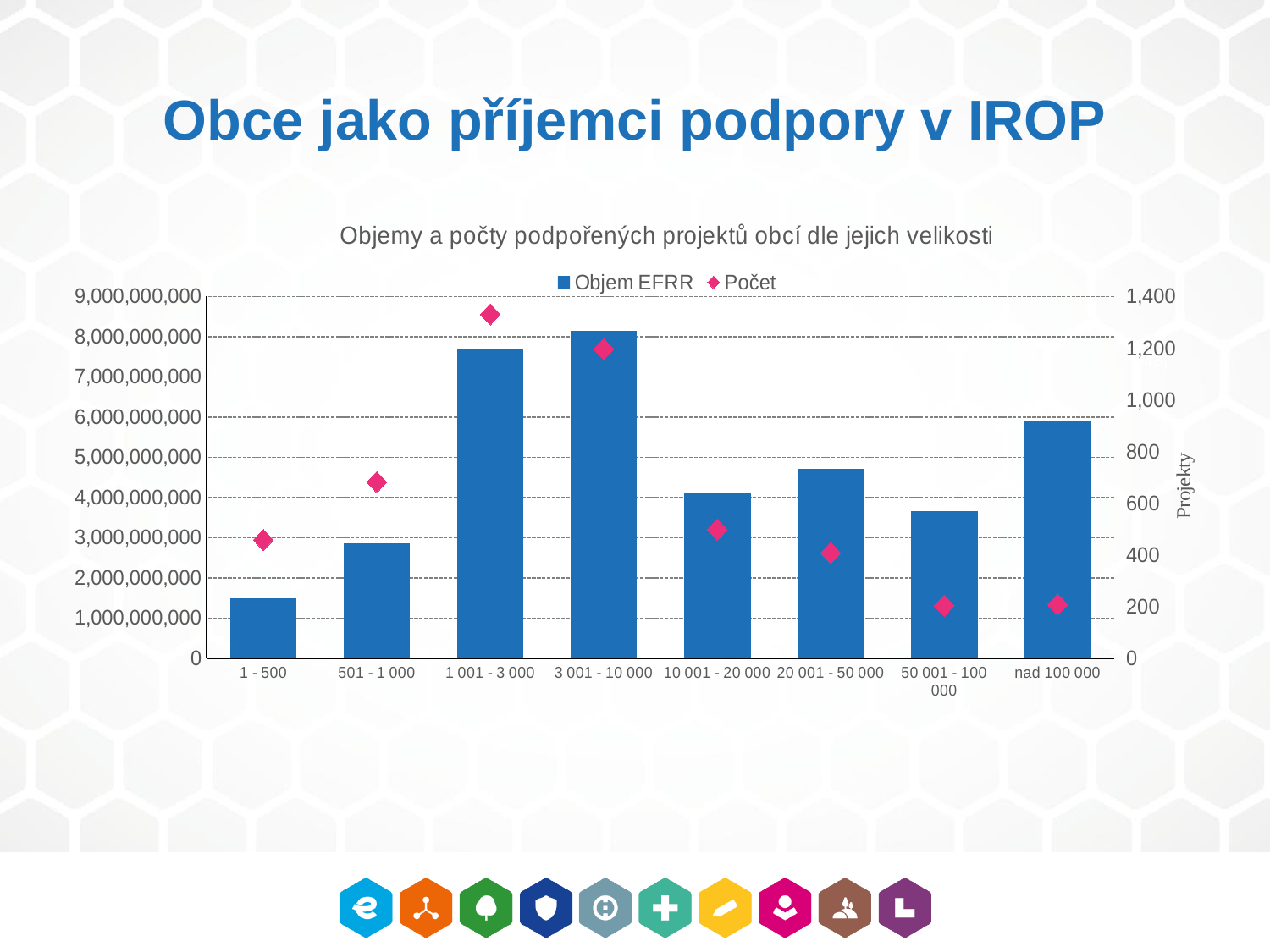
Which category has the lowest Objem EFRR bar? 1 - 500 Which has the larger Objem EFRR bar: nad 100 000 or 20 001 - 50 000? nad 100 000 What is the title of the chart? Objemy a počty podpořených projektů obcí dle jejich velikosti Is the Objem EFRR value for 1 - 500 greater or less than 2,000,000,000? less What colour are the Počet markers? Pink (magenta) diamonds How many municipality size categories are shown on the x axis? 8 Which category has the highest Počet marker? 1 001 - 3 000 Is the Počet value for 501 - 1 000 greater or less than 600? greater Is the Objem EFRR value for 1 001 - 3 000 greater or less than 7,000,000,000? greater How many series does the chart legend list? 2 Which category has the highest Objem EFRR bar? 3 001 - 10 000